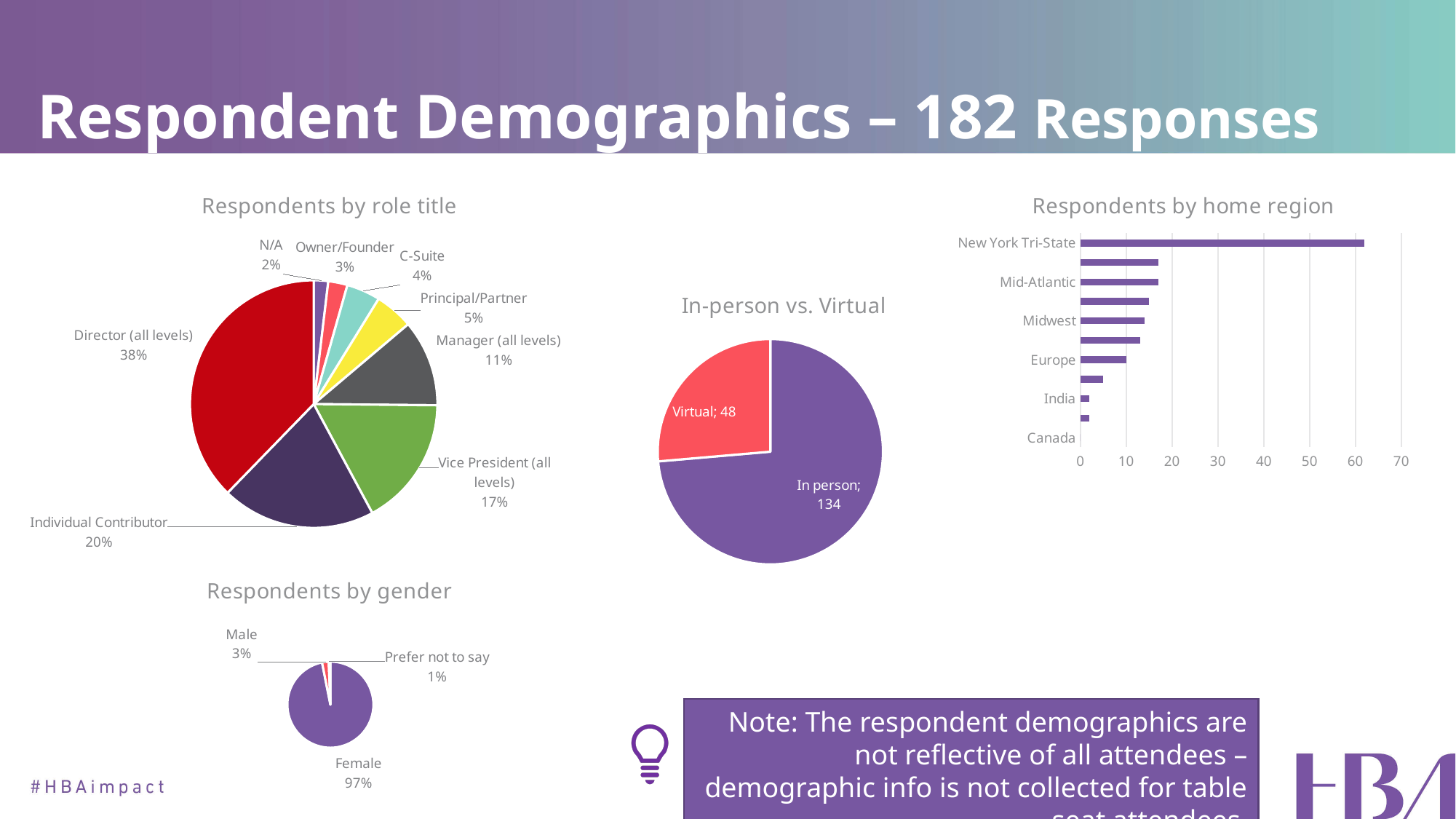
In the 'In-person vs. Virtual' chart, how many respondents attended in person? 134 In the 'Respondents by role title' chart, how many slices does the pie have? 8 In the 'Respondents by role title' chart, what percentage of respondents are Director (all levels)? 38% In the 'Respondents by home region' chart, which region has the longest bar? New York Tri-State In the 'In-person vs. Virtual' chart, how many more respondents were in person than virtual? 86 In the 'Respondents by home region' chart, is the value for New York Tri-State greater or less than 50? greater In the 'Respondents by role title' chart, which role title has the largest share? Director (all levels) In the 'Respondents by home region' chart, what kind of chart is used? Bar chart In the 'Respondents by role title' chart, which role title has the smallest share? N/A In the 'Respondents by gender' chart, what percentage of respondents are Female? 97% In the 'In-person vs. Virtual' chart, what kind of chart is used? Pie chart In the 'Respondents by role title' chart, what is the difference in percentage points between Individual Contributor and Vice President (all levels)? 3